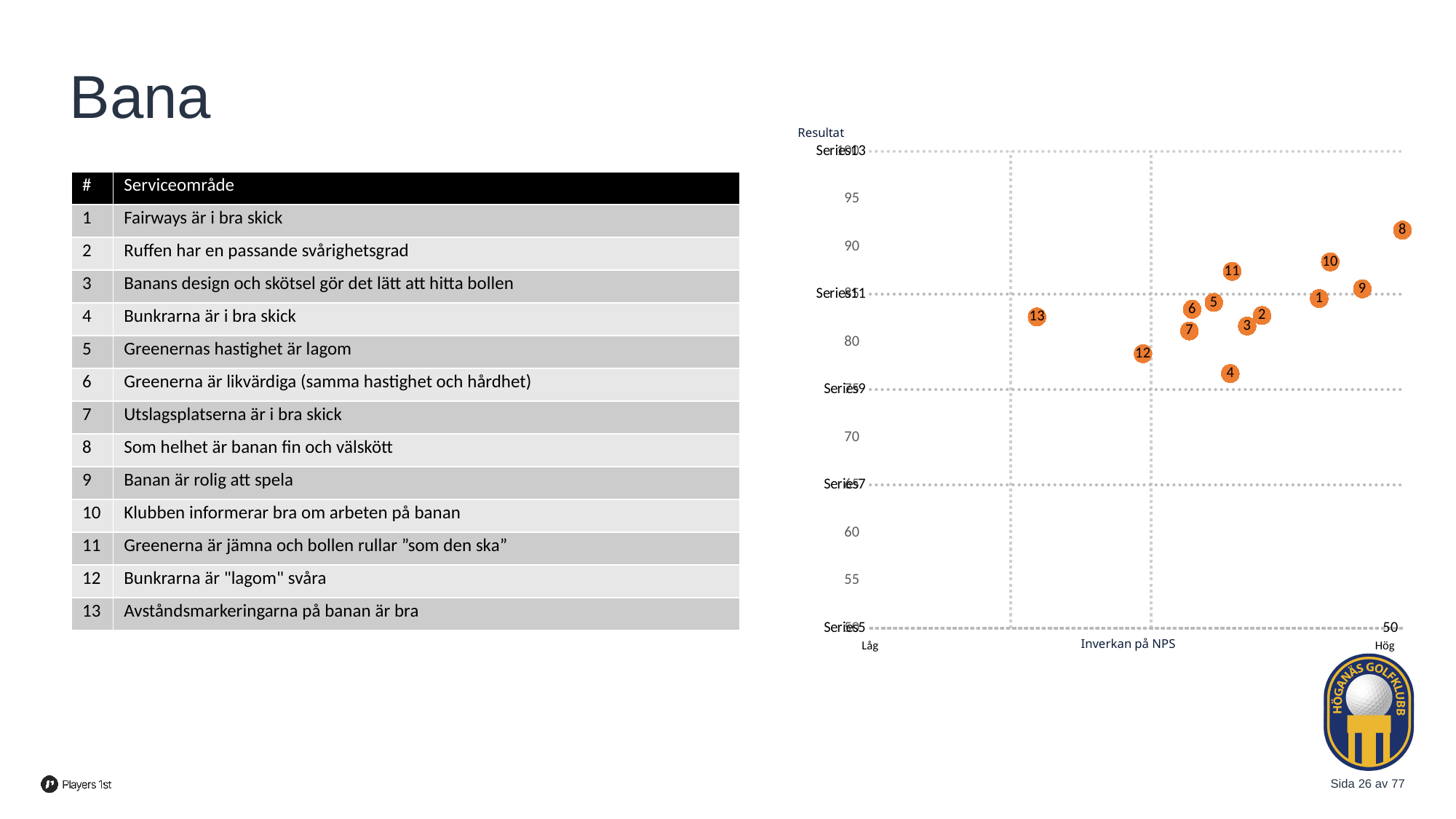
What is the title of the horizontal axis of the chart? Inverkan på NPS Is the Resultat value for point 10 greater or less than 90? less Which numbered point lies furthest to the left (lowest Inverkan på NPS) in the chart? 13 Is the Resultat value for point 4 greater or less than 80? less Which has the higher Resultat value, point 11 or point 7? point 11 How many numbered data points are plotted in the chart? 13 Which has the higher Resultat value, point 13 or point 12? point 13 Which numbered point has the highest Resultat value in the chart? 8 Is the Resultat value for point 11 greater or less than 85? greater What kind of chart is shown on the slide? scatter chart Which numbered point has the lowest Resultat value in the chart? 4